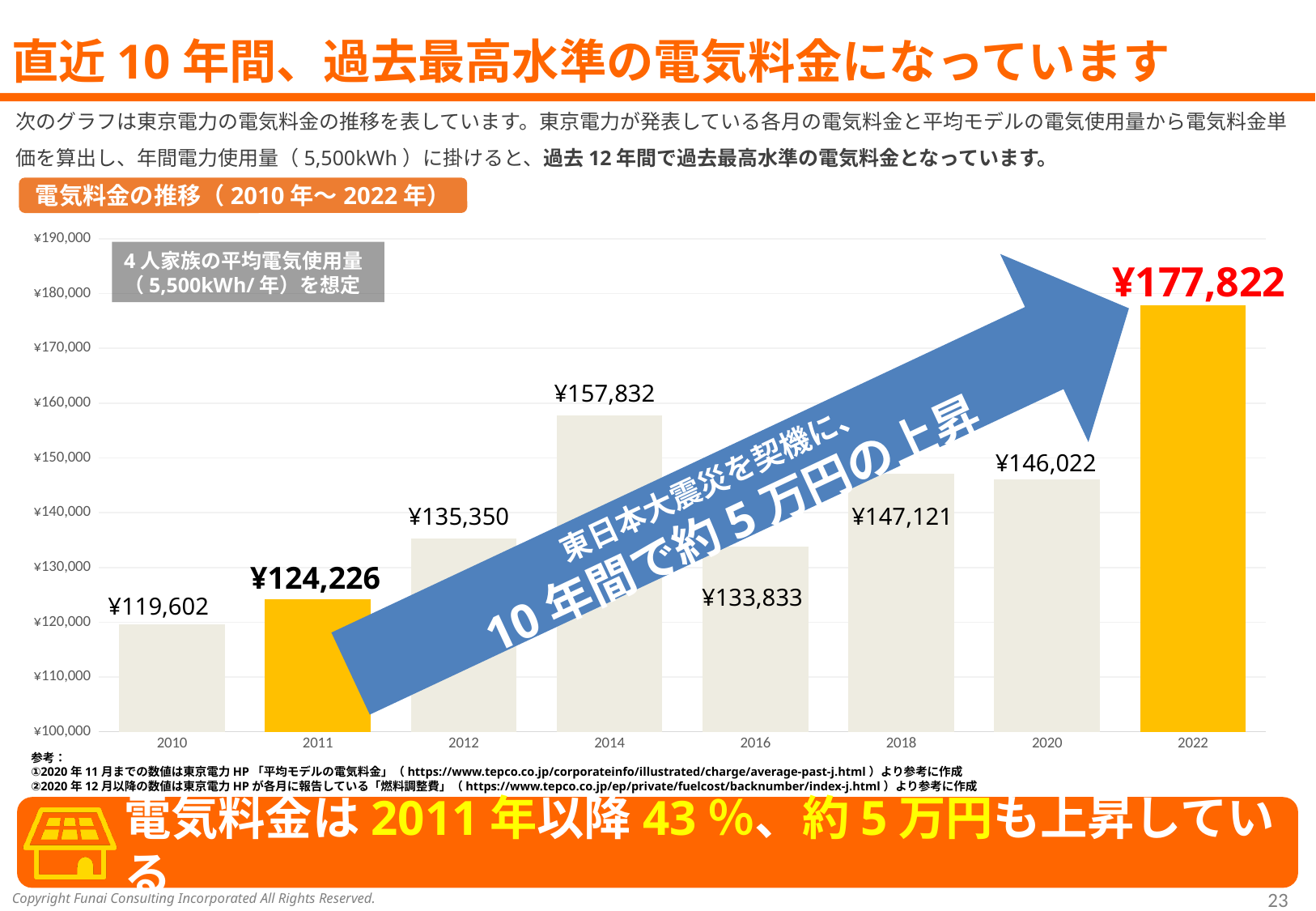
What is the difference between the 2022 value and the 2011 value? ¥53,596 Is the value for 2016 greater or less than ¥130,000? greater What is the difference between the 2014 value and the 2012 value? ¥22,482 Which year has the highest electricity charge in the chart? 2022 Between 2014 and 2016, does the electricity charge rise or fall? fall What is the electricity charge shown for 2010? ¥119,602 Which is larger, the value for 2014 or the value for 2018? 2014 What kind of chart is shown on the slide? bar chart What is the value shown for 2016? ¥133,833 How many years are shown on the x axis of the chart? 8 What is the electricity charge shown for 2022? ¥177,822 Which year has the lowest electricity charge in the chart? 2010